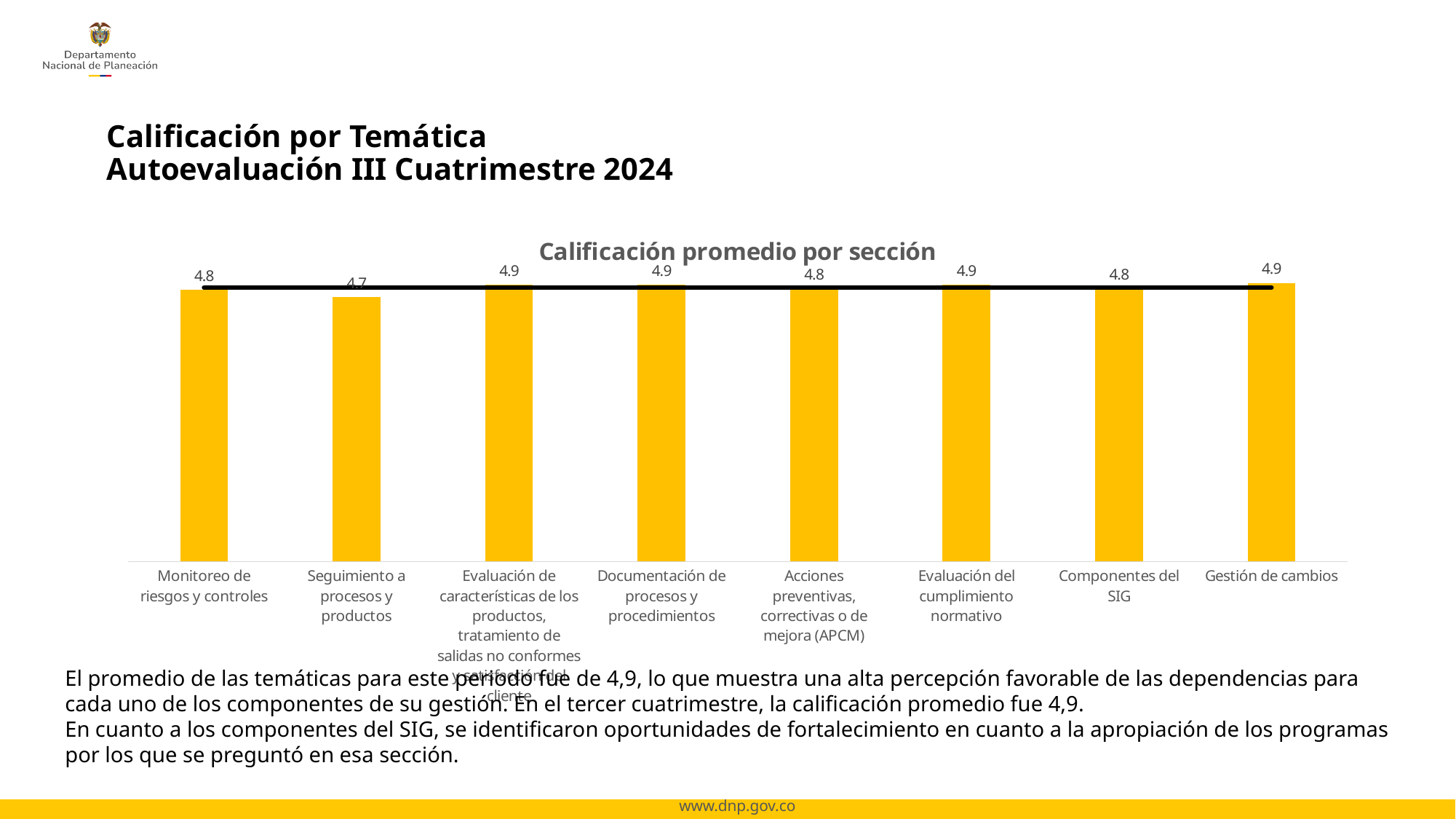
What type of chart is shown on the slide? combination bar and line chart What is the value for Acciones preventivas, correctivas o de mejora (APCM)? 4.8 How many categories are shown in the chart? 8 What is the value for Documentación de procesos y procedimientos? 4.9 Which is larger, the value for Componentes del SIG or the value for Gestión de cambios? Gestión de cambios What colour are the bars in the chart? yellow What is the value for Gestión de cambios? 4.9 What is the title of the chart? Calificación promedio por sección What is the value for Monitoreo de riesgos y controles? 4.8 Which category has the lowest value? Seguimiento a procesos y productos What is the value for Seguimiento a procesos y productos? 4.7 What is the difference between the values for Evaluación del cumplimiento normativo and Seguimiento a procesos y productos? 0.2